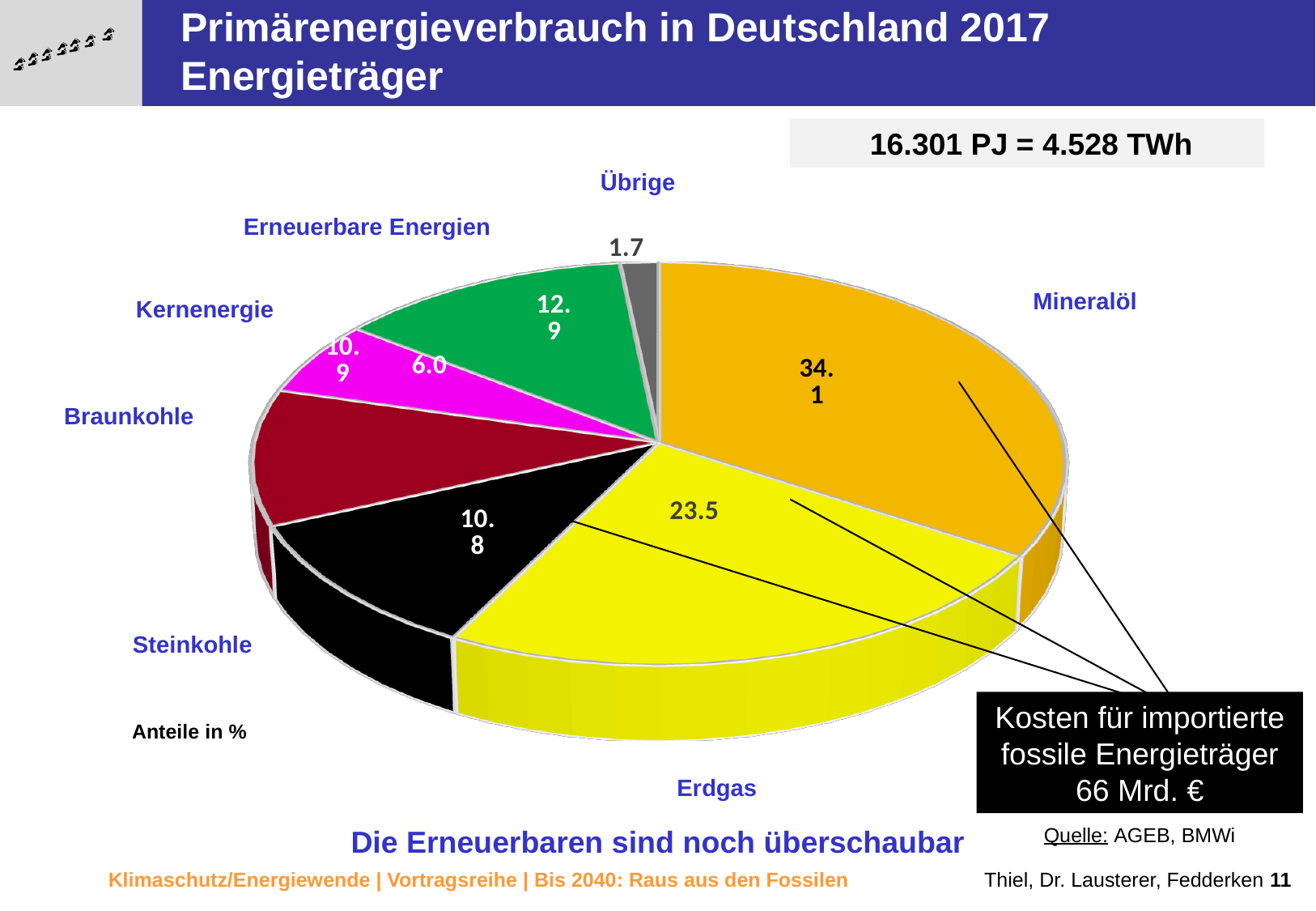
What share do Erneuerbare Energien have in the pie chart? 12.9 What total primary energy consumption is stated on the slide? 16.301 PJ = 4.528 TWh Which energy source has the largest slice of the pie chart? Mineralöl How many energy sources (slices) are shown in the pie chart? 7 How many percentage points larger is the share of Mineralöl than that of Erdgas? 10.6 What share does Steinkohle have in the pie chart? 10.8 Which has the larger share, Erneuerbare Energien or Steinkohle? Erneuerbare Energien What share does Erdgas have in the pie chart? 23.5 What kind of chart is shown on the slide? pie chart What share does Übrige have in the pie chart? 1.7 Which energy source has the smallest slice of the pie chart? Übrige What share does Mineralöl have in the pie chart? 34.1